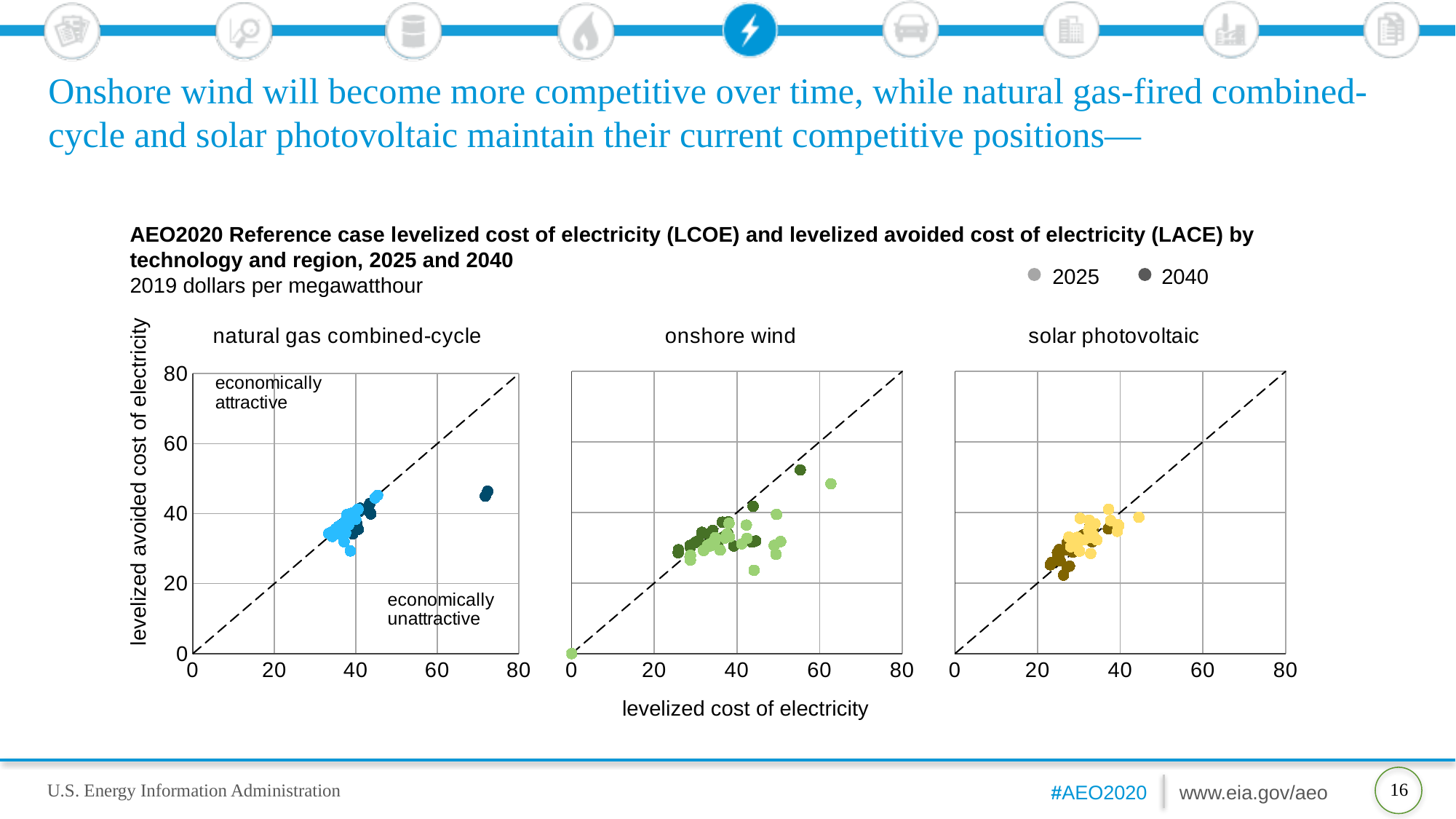
What are the two series named in the legend? 2025 and 2040 Which chart contains the point with the highest levelized cost of electricity: natural gas combined-cycle or onshore wind? natural gas combined-cycle In the solar photovoltaic chart, is the highest levelized cost of electricity value greater or less than 60? less What unit is given under the chart title? 2019 dollars per megawatthour In the natural gas combined-cycle chart, is the levelized cost of electricity of the rightmost point greater or less than 60? greater In the natural gas combined-cycle chart, is the lowest levelized avoided cost of electricity value greater or less than 40? less How many series does the legend list? 2 What kind of chart is used for the natural gas combined-cycle, onshore wind and solar photovoltaic panels? scatter chart In the onshore wind chart, do the points generally rise or fall as levelized cost of electricity increases along the x axis? rise